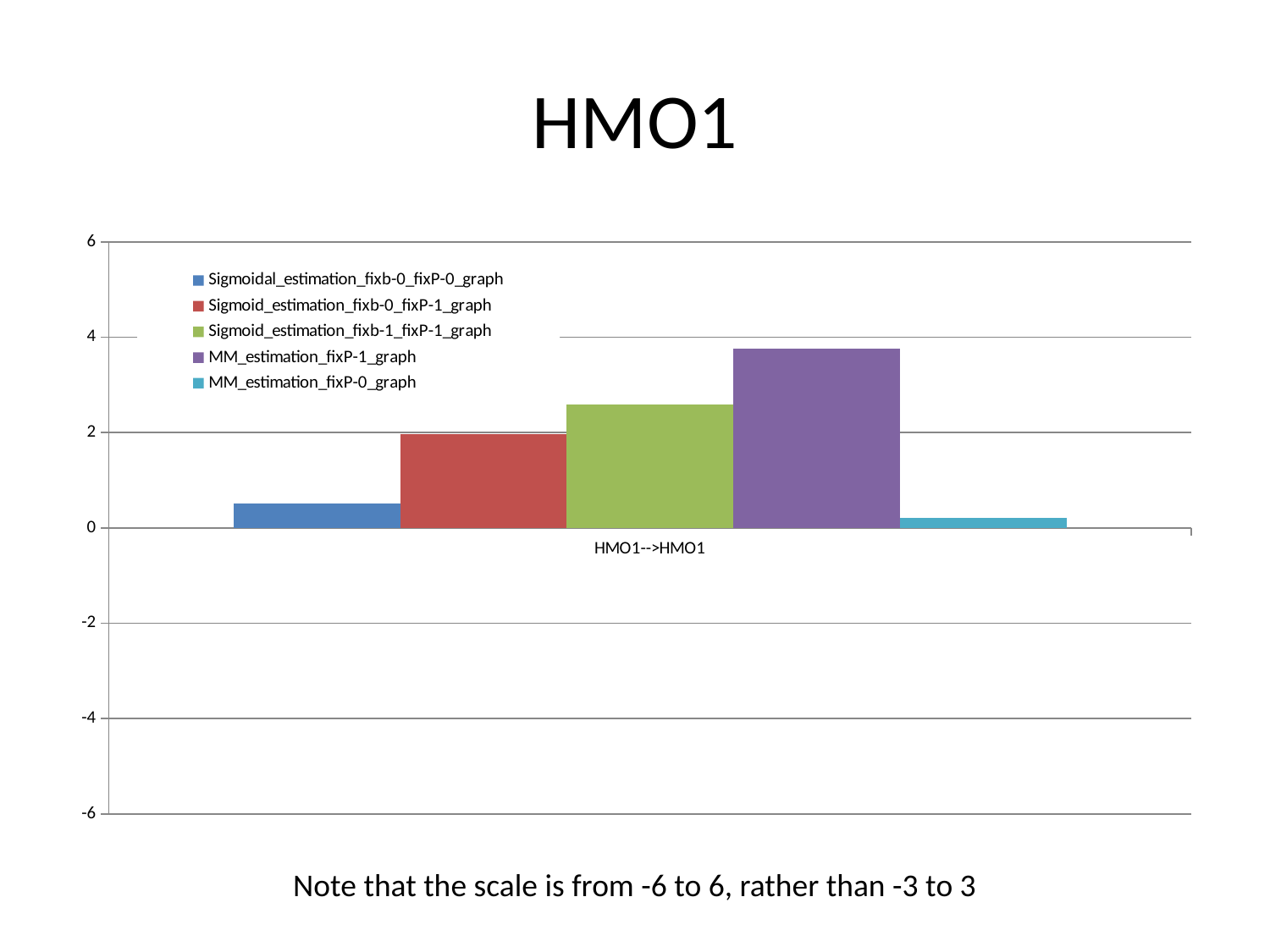
Is the value for Sigmoidal_estimation_fixb-0_fixP-0_graph greater or less than 2? less Which series has the highest value for HMO1-->HMO1? MM_estimation_fixP-1_graph Is the value for Sigmoid_estimation_fixb-1_fixP-1_graph greater or less than 2? greater Which is larger, the value for Sigmoid_estimation_fixb-1_fixP-1_graph or Sigmoid_estimation_fixb-0_fixP-1_graph? Sigmoid_estimation_fixb-1_fixP-1_graph What is the title of the slide containing the chart? HMO1 How many series does the legend list? 5 How many categories are shown on the x axis? 1 What is the label of the single category on the x axis? HMO1-->HMO1 Which series has the lowest value for HMO1-->HMO1? MM_estimation_fixP-0_graph Is the value for MM_estimation_fixP-1_graph greater or less than 4? less What kind of chart is shown on the slide? bar chart